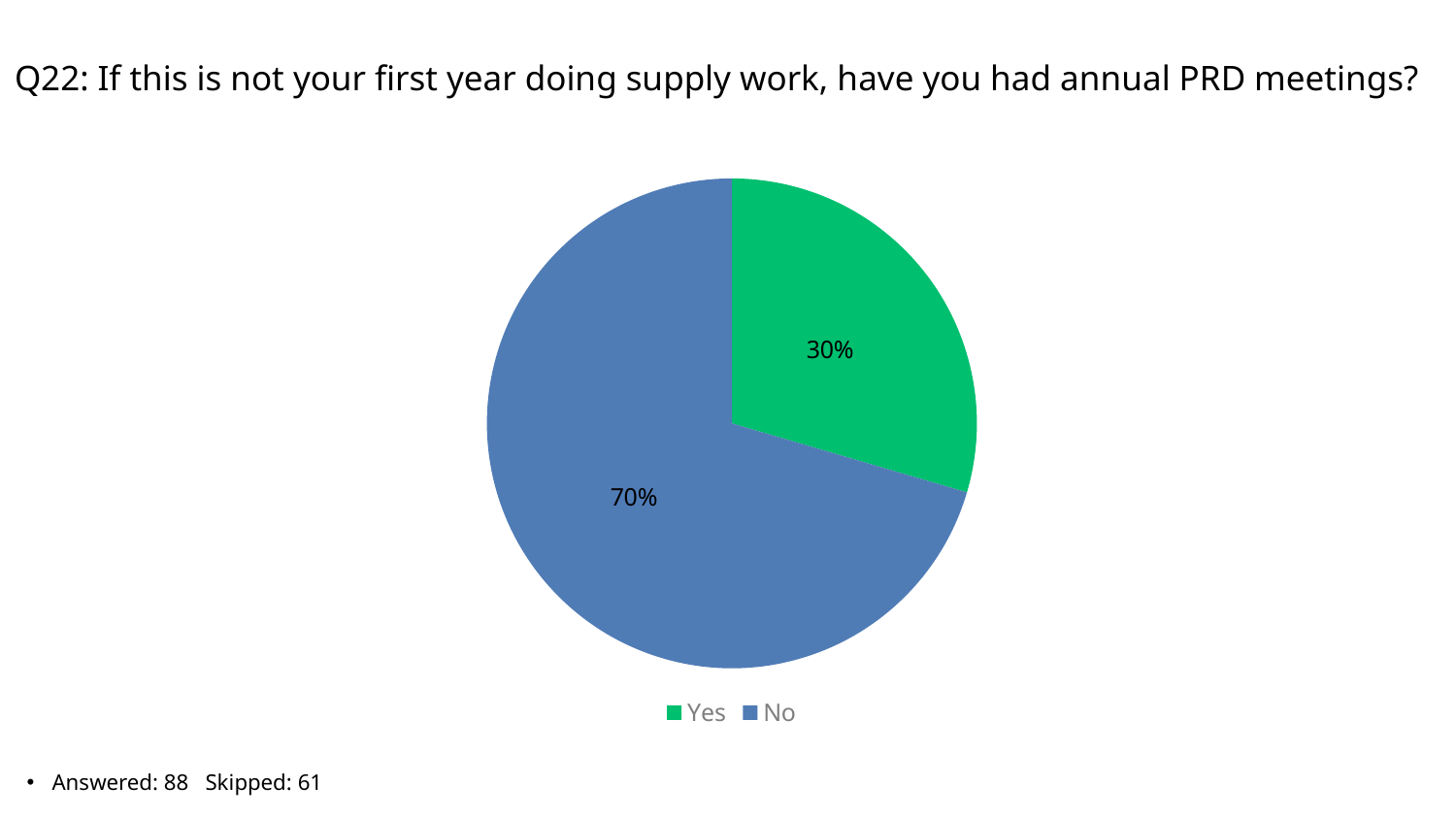
What is the difference in percentage points between the No and Yes slices? 40 How many entries does the legend list? 2 What share of the pie does the Yes slice represent? 30% Which slice is larger, Yes or No? No Which response has the largest share of the pie? No What percentage of respondents answered No? 70% Which response has the smallest share of the pie? Yes How many slices does the pie chart have? 2 How many respondents answered this question according to the slide? 88 What colour is the Yes slice? green What kind of chart is shown on the slide? pie chart What percentage of respondents answered Yes? 30%